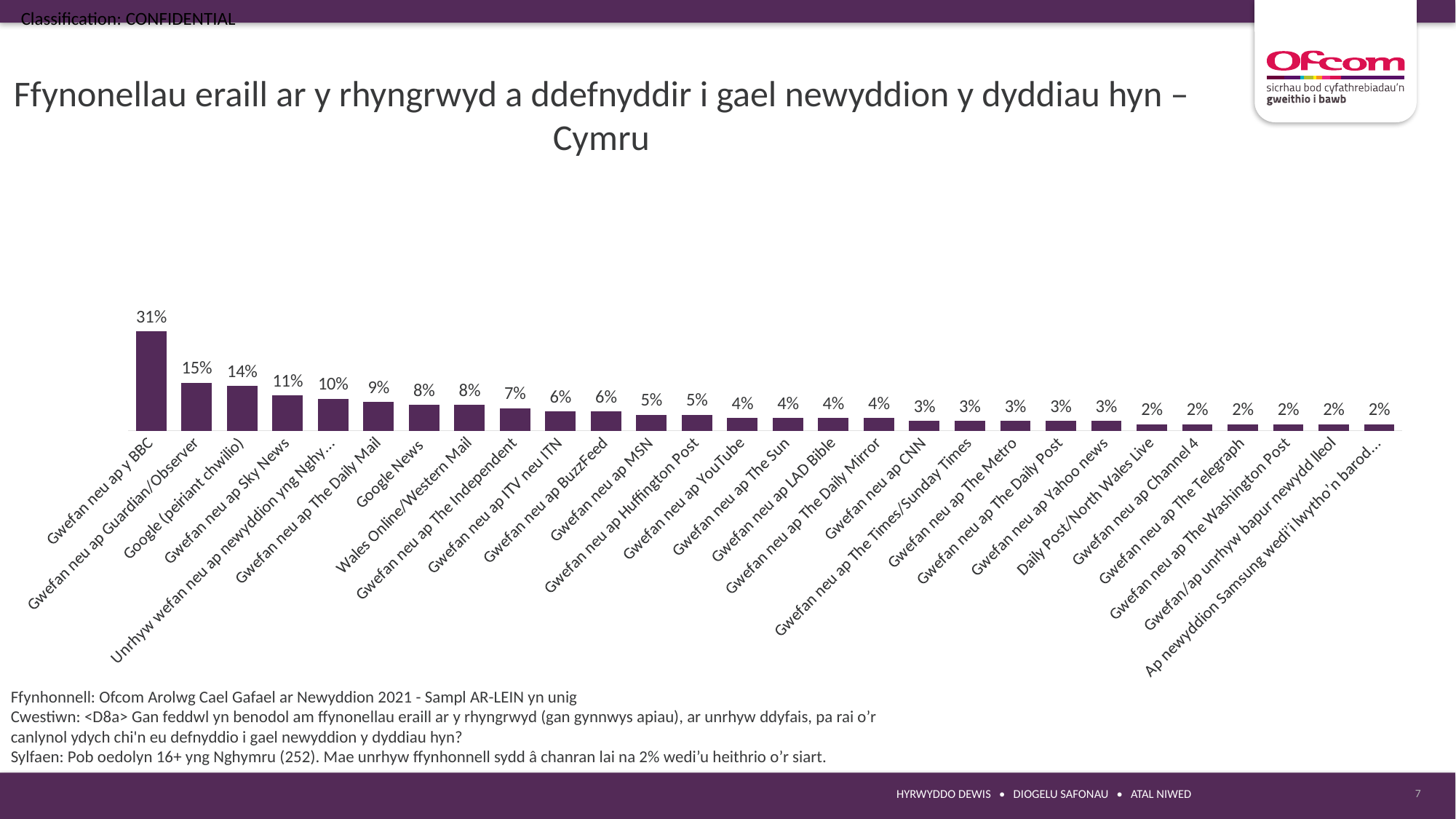
Which is larger, the value for Google News or the value for Gwefan neu ap CNN? Google News What is the value for Google (peiriant chwilio)? 14% What is the value for Gwefan neu ap y BBC? 31% What is the value for Wales Online/Western Mail? 8% Which category has the highest value? Gwefan neu ap y BBC How many categories are shown in the chart? 28 What kind of chart is shown on the slide? Bar chart What is the difference between the values for Gwefan neu ap y BBC and Gwefan neu ap Guardian/Observer? 16% What is the difference between the values for Gwefan neu ap Sky News and Gwefan neu ap The Daily Mail? 2% Do the values rise or fall from left to right along the x axis? Fall What is the value for Gwefan neu ap The Daily Mirror? 4% Which is larger, the value for Gwefan neu ap Sky News or the value for Gwefan neu ap MSN? Gwefan neu ap Sky News